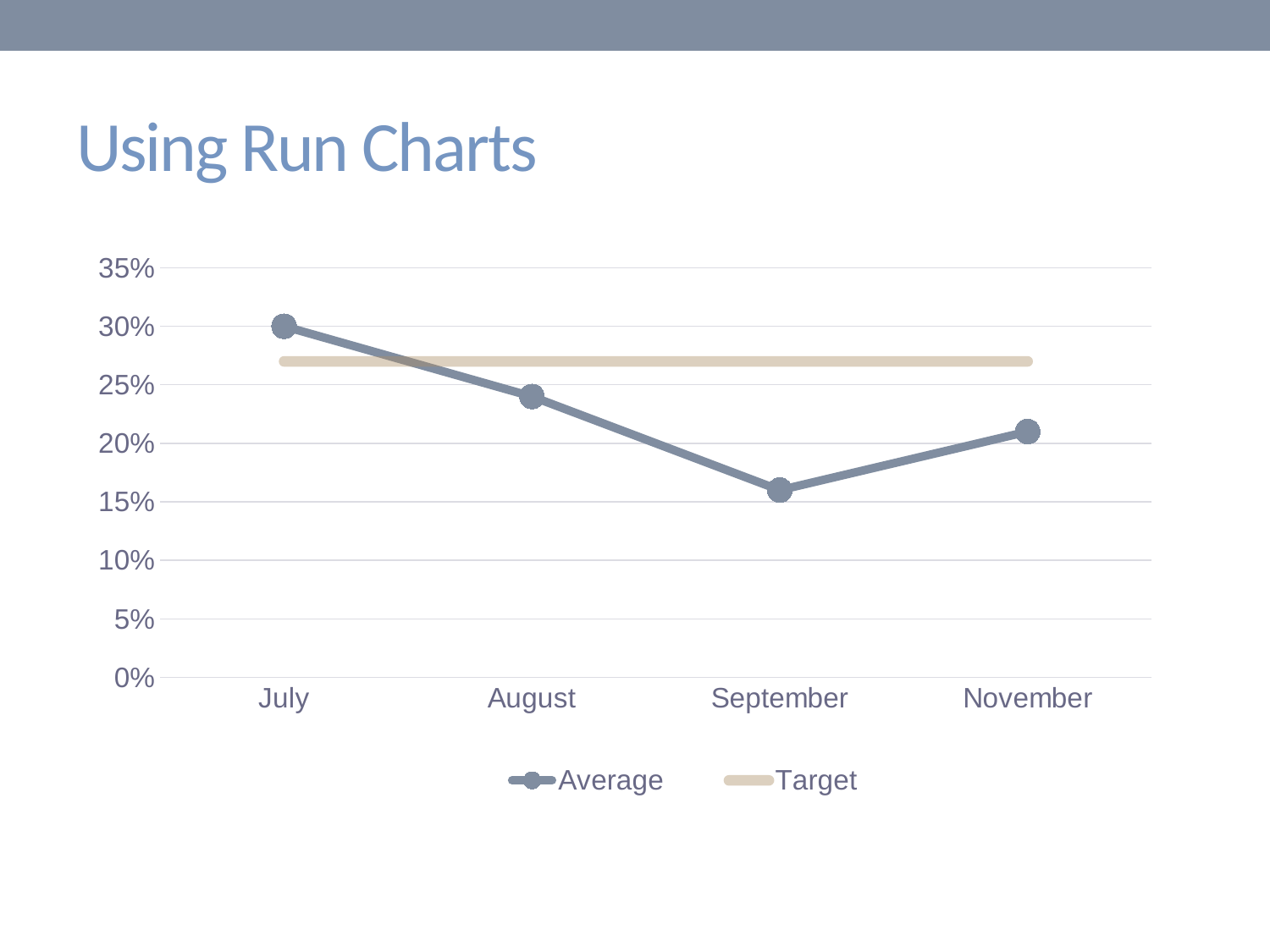
Which is larger, the Average value for August or the Average value for November? August What kind of chart is shown on the slide? line chart Is the Target line greater or less than 25%? greater Is the Average value for August greater or less than 20%? greater Does the Average series rise or fall from July to September? fall Which month has the highest Average value? July Is the Average value for September greater or less than 20%? less How many series does the legend list? 2 What are the two series named in the legend? Average and Target Which month has the lowest Average value? September What is the Average value for July? 30% How many months are shown on the x axis? 4